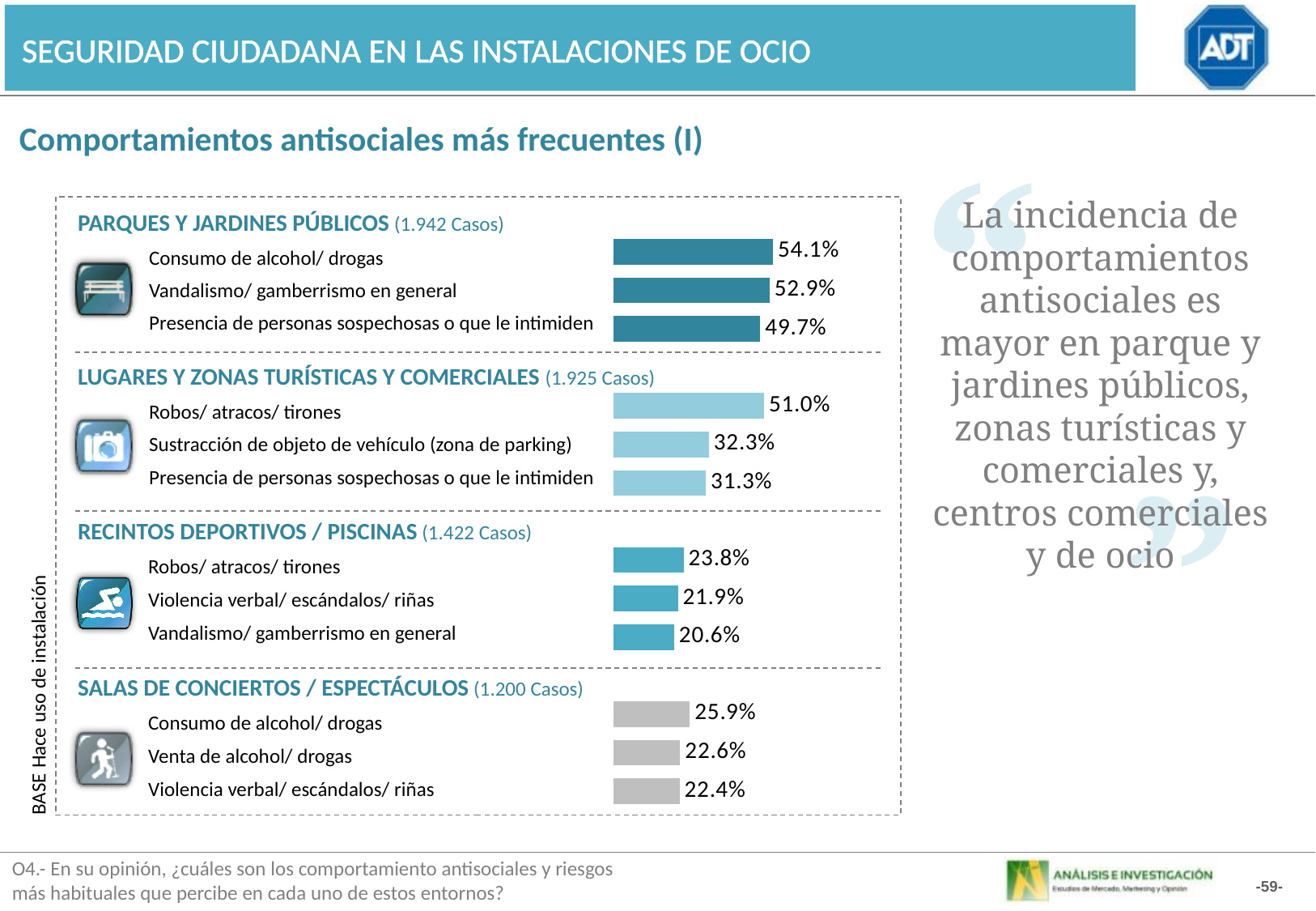
In the 'Parques y jardines públicos' chart, what is the value for 'Consumo de alcohol/ drogas'? 54.1% In the 'Recintos deportivos / piscinas' chart, which is larger: 'Robos/ atracos/ tirones' or 'Vandalismo/ gamberrismo en general'? Robos/ atracos/ tirones In the 'Lugares y zonas turísticas y comerciales' chart, what is the value for 'Sustracción de objeto de vehículo (zona de parking)'? 32.3% How many cases (Casos) are indicated for the 'Recintos deportivos / piscinas' chart? 1.422 Casos In the 'Parques y jardines públicos' chart, what is the difference between 'Consumo de alcohol/ drogas' and 'Presencia de personas sospechosas o que le intimiden'? 4.4% In the 'Lugares y zonas turísticas y comerciales' chart, what is the difference between 'Robos/ atracos/ tirones' and 'Sustracción de objeto de vehículo (zona de parking)'? 18.7% In the 'Parques y jardines públicos' chart, which category has the lowest value? Presencia de personas sospechosas o que le intimiden In the 'Salas de conciertos / espectáculos' chart, what is the value for 'Venta de alcohol/ drogas'? 22.6% How many categories are shown in the 'Salas de conciertos / espectáculos' chart? 3 In the 'Lugares y zonas turísticas y comerciales' chart, which category has the highest value? Robos/ atracos/ tirones In the 'Recintos deportivos / piscinas' chart, what is the value for 'Violencia verbal/ escándalos/ riñas'? 21.9% What kind of chart is used in the 'Parques y jardines públicos' section? Bar chart